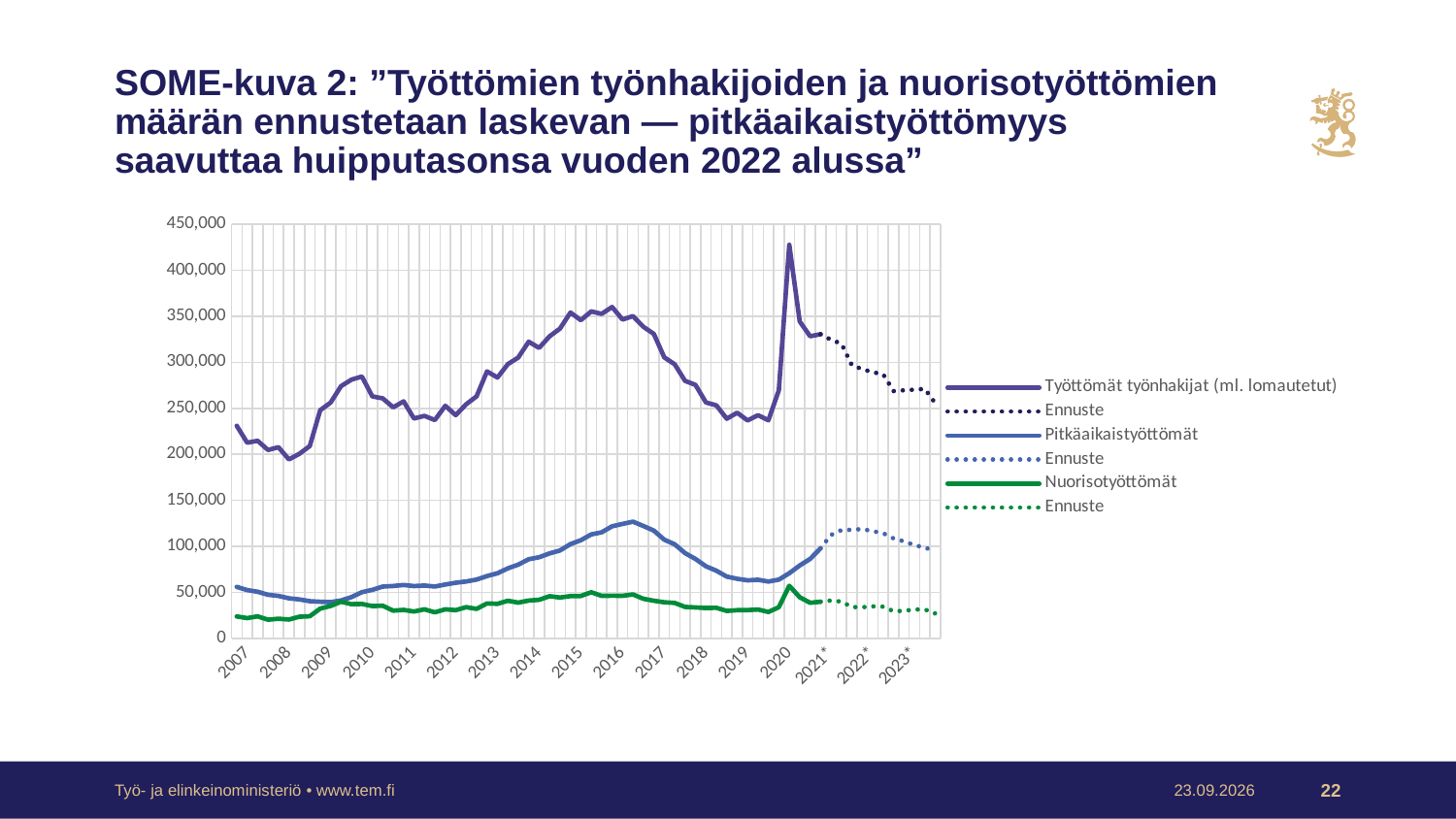
Is the value for Työttömät työnhakijat (ml. lomautetut) in 2008 greater or less than 250,000? less Which series reaches the highest value on the chart? Työttömät työnhakijat (ml. lomautetut) What kind of chart is shown on the slide? line chart How many year labels are shown on the x axis of the chart? 17 How many entries does the chart legend list? 6 Does the forecast for Työttömät työnhakijat (ml. lomautetut) rise or fall from 2021* to 2023*? fall Is the peak value of Työttömät työnhakijat (ml. lomautetut) in 2020 greater or less than 400,000? greater Is the forecast (Ennuste) value for Nuorisotyöttömät in 2023* greater or less than 50,000? less In 2016, which is larger: Pitkäaikaistyöttömät or Nuorisotyöttömät? Pitkäaikaistyöttömät Which series has the lowest values on the chart? Nuorisotyöttömät What colour is the Nuorisotyöttömät line in the chart? green